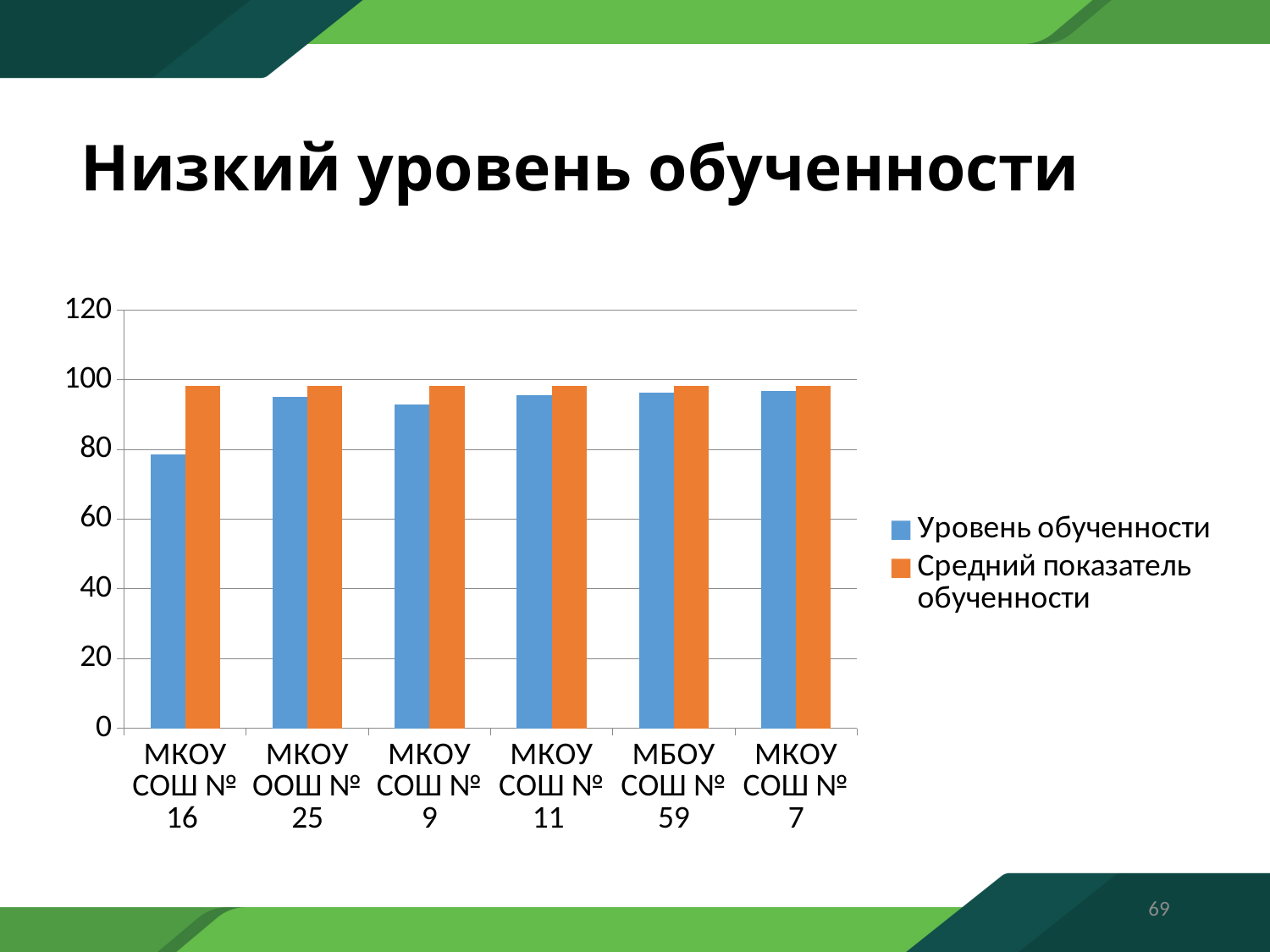
Is the Уровень обученности value for МКОУ СОШ № 16 greater or less than 60? greater Is the Уровень обученности value for МКОУ СОШ № 9 greater or less than 80? greater Which colour represents the Уровень обученности series in the chart? blue Is the Уровень обученности value for МКОУ СОШ № 16 greater or less than 80? less What is the title of the slide containing the chart? Низкий уровень обученности How many schools (categories) are shown on the x axis of the chart? 6 How many series does the chart legend list? 2 Which school has the lowest value for Уровень обученности? МКОУ СОШ № 16 What kind of chart is shown on the slide? bar chart For МКОУ СОШ № 16, which is larger: Уровень обученности or Средний показатель обученности? Средний показатель обученности Which is larger: the Уровень обученности value for МКОУ СОШ № 16 or for МКОУ ООШ № 25? МКОУ ООШ № 25